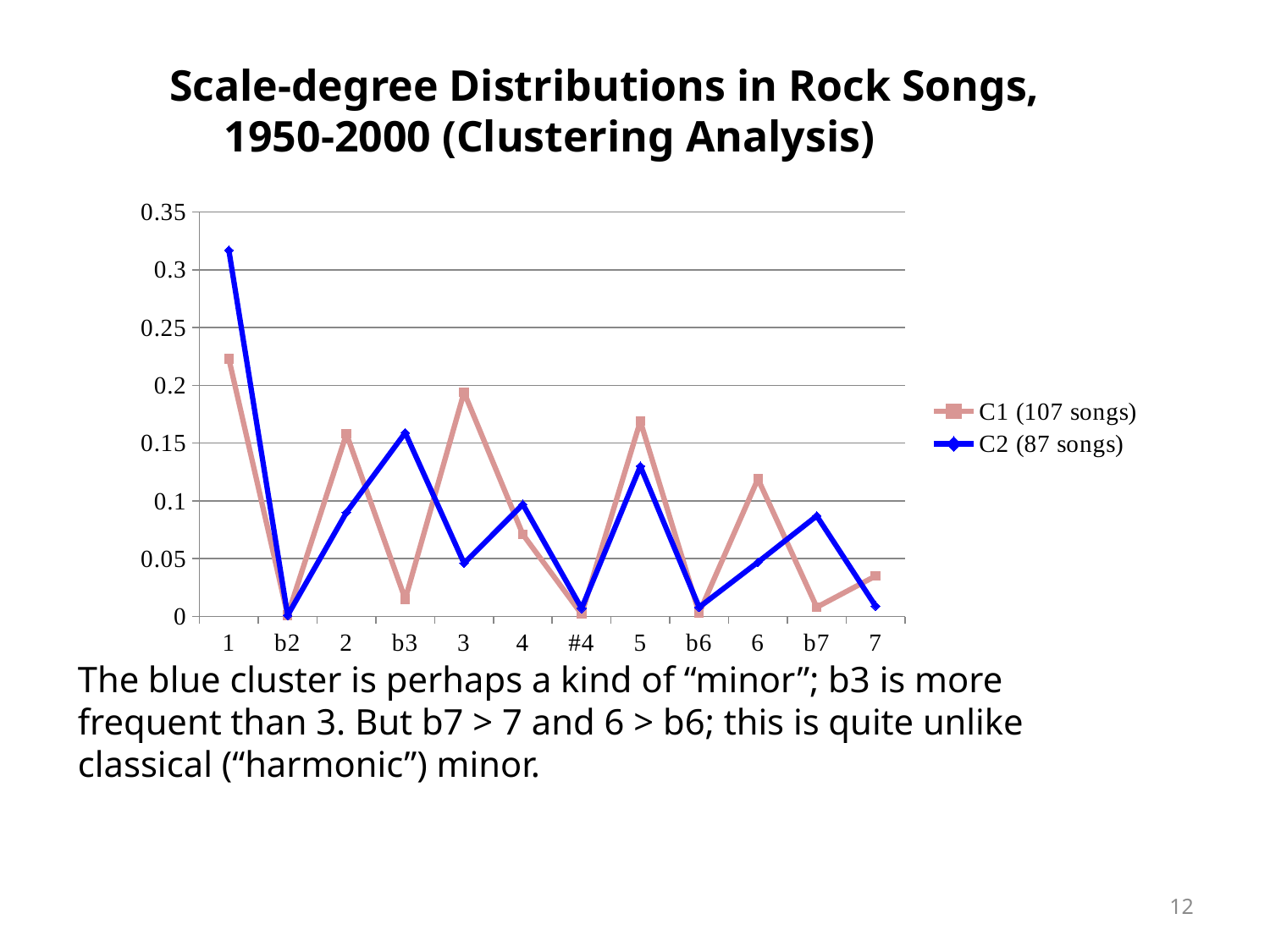
How many series does the legend list? 2 At scale degree 3, which series has the larger value, C1 (107 songs) or C2 (87 songs)? C1 (107 songs) Is the value for C2 (87 songs) at scale degree 1 greater or less than 0.3? greater Which colour is used for the C2 (87 songs) series? Blue Is the value for C2 (87 songs) at scale degree b7 greater or less than 0.1? less How many scale-degree categories are shown on the x axis? 12 Which scale degree has the highest value for the C2 (87 songs) series? 1 Is the value for C1 (107 songs) at scale degree 1 greater or less than 0.2? greater What kind of chart is shown on the slide? Line chart At scale degree b3, which series has the larger value, C1 (107 songs) or C2 (87 songs)? C2 (87 songs) Which scale degree has the highest value for the C1 (107 songs) series? 1